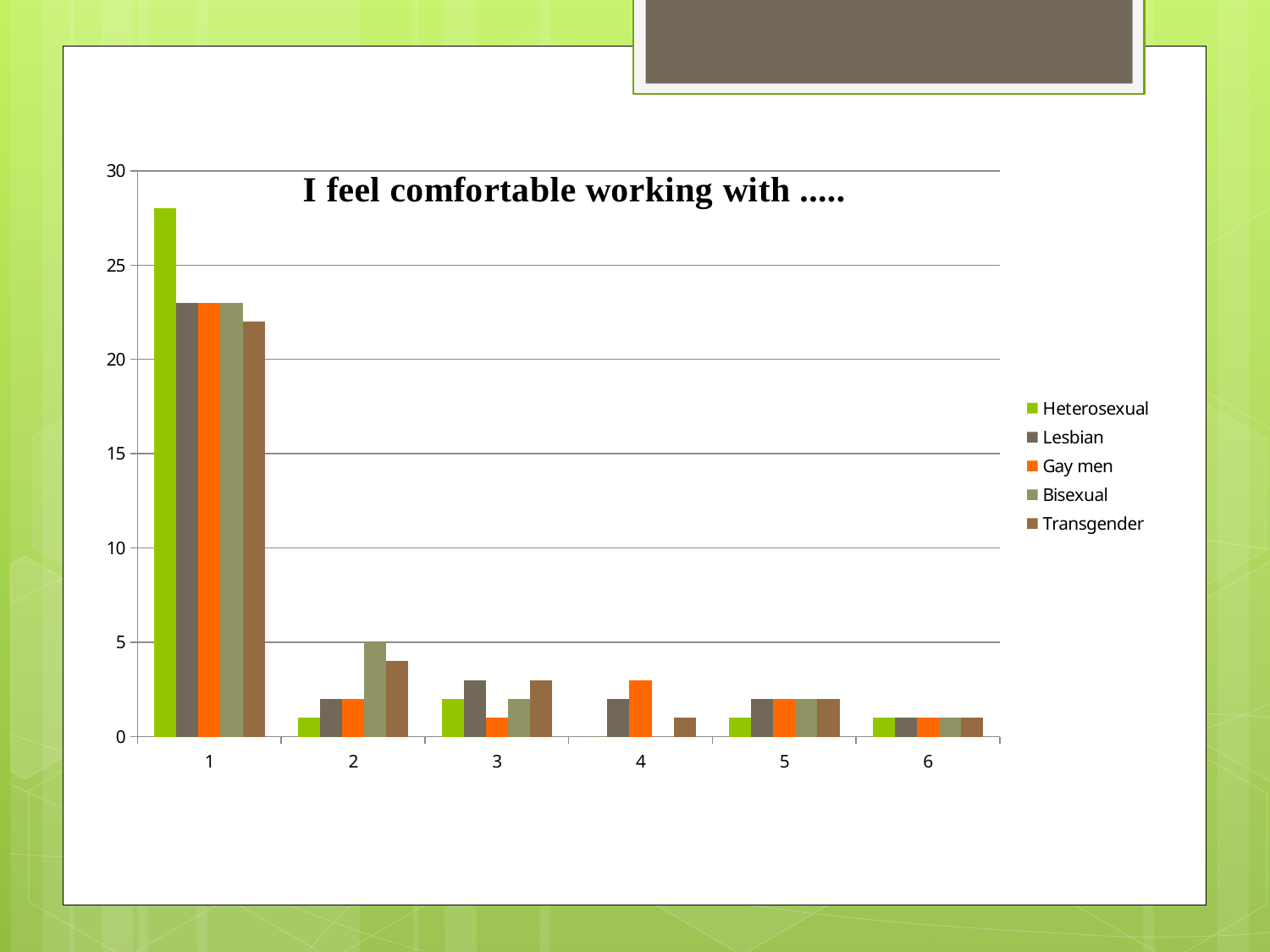
In category 2, which is larger: the Bisexual bar or the Heterosexual bar? Bisexual Is the value for Heterosexual in category 1 greater or less than 25? greater Do the Heterosexual values generally rise or fall from category 1 to category 6? fall How many series does the legend list? 5 Is the value for Transgender in category 1 greater or less than 25? less What is the title of the chart? I feel comfortable working with ..... What kind of chart is shown on the slide? bar chart Is the value for Lesbian in category 1 greater or less than 20? greater How many categories are shown on the x axis? 6 In category 1, which series has the highest bar? Heterosexual What colour represents the Gay men series in the legend? orange Which category has the tallest bars overall? 1